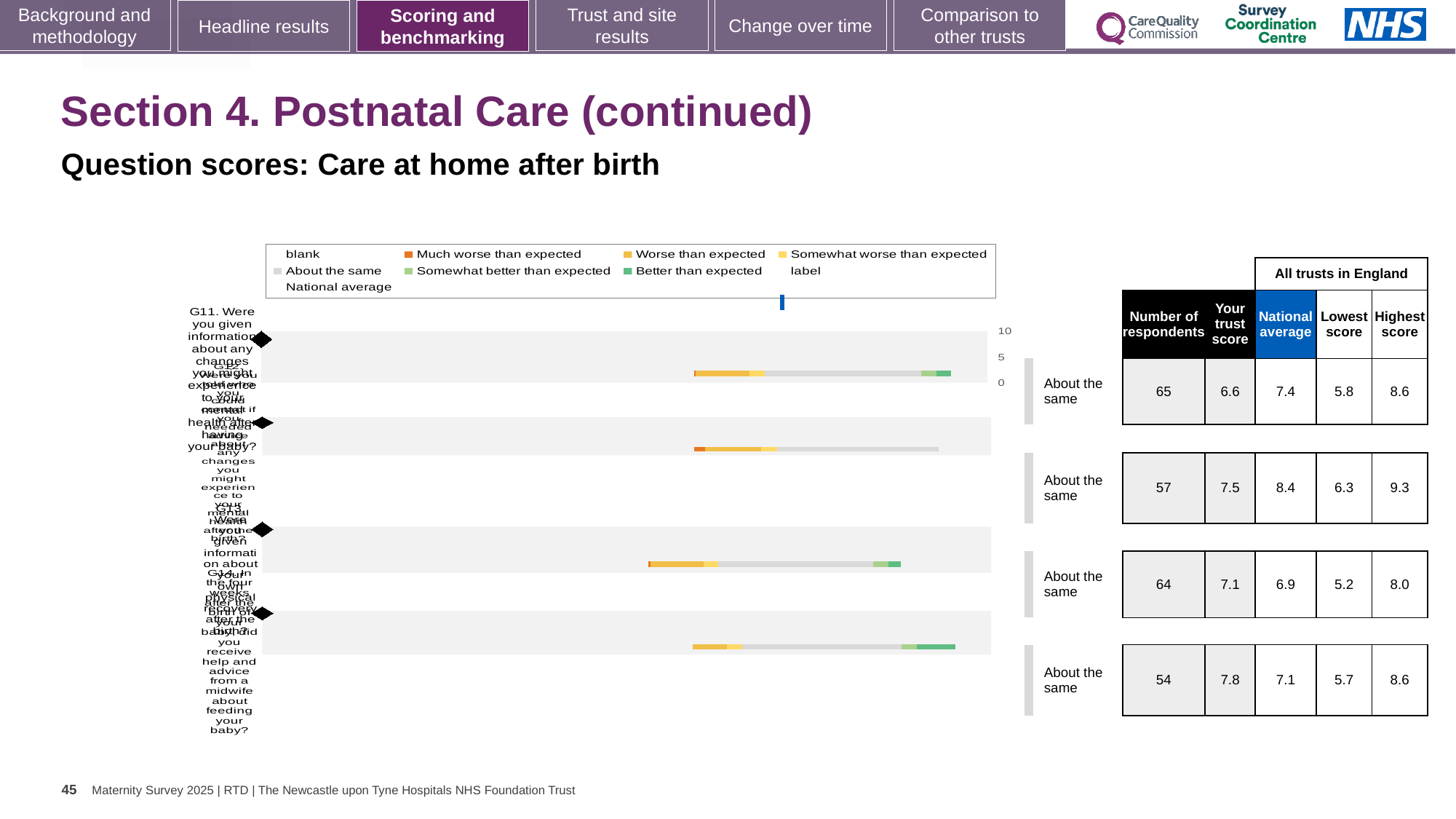
For the first (top) row, what is the difference between the national average and the trust score? 0.8 For the second row, which is larger: the trust score or the national average? the national average (8.4) In the table beside the chart, what is the highest score for the fourth (bottom) row? 8.6 Which row has the lowest 'Lowest score' in the table beside the chart? the third row, 5.2 What kind of chart is shown on the slide? bar chart What benchmark label is shown next to each of the four bars? About the same In the table beside the chart, what is the national average for the third row? 6.9 In the table beside the chart, what is the 'Your trust score' for the second row? 7.5 How many question rows (bars) are plotted in the chart? 4 In the table beside the chart, what is the number of respondents for the first (top) row? 65 Which row has the highest 'Your trust score' in the table beside the chart? the fourth (bottom) row, 7.8 What colour represents 'Much worse than expected' in the chart legend? orange